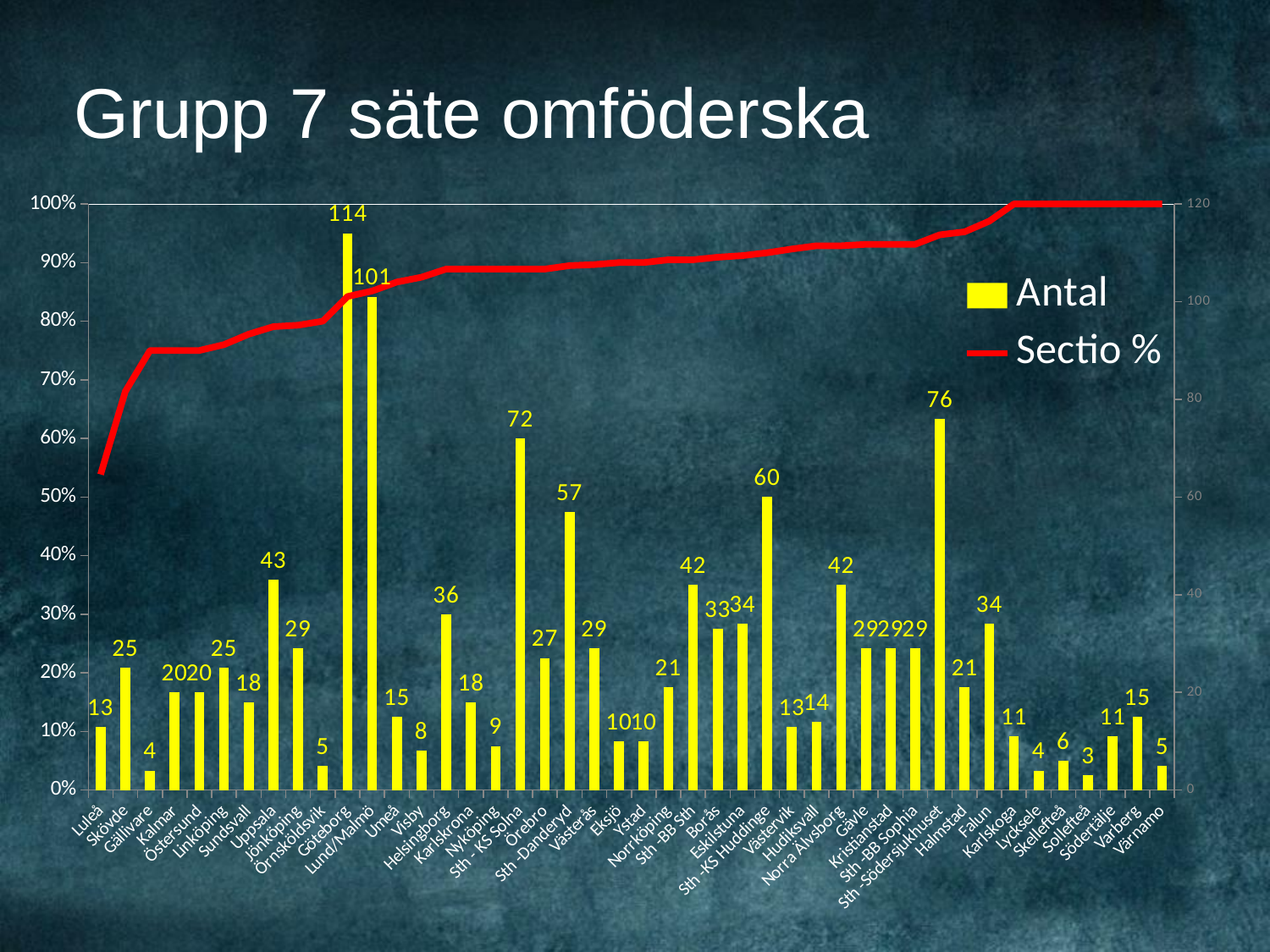
Which category has the highest Antal value? Göteborg What is the Antal value for Göteborg? 114 Is the Sectio % value for Luleå greater or less than 50%? greater Which category has the lowest Antal value? Sollefteå What is the Antal value for Sth - KS Solna? 72 Does the Sectio % line rise or fall from left to right along the x axis? rises What is the Antal value for Sth - Södersjukhuset? 76 What are the two entries in the chart legend? Antal and Sectio % Which has a larger Antal value, Uppsala or Helsingborg? Uppsala How many series does the legend list? 2 What is the difference in Antal between Göteborg and Lund/Malmö? 13 Is the Sectio % value for Göteborg greater or less than 90%? less